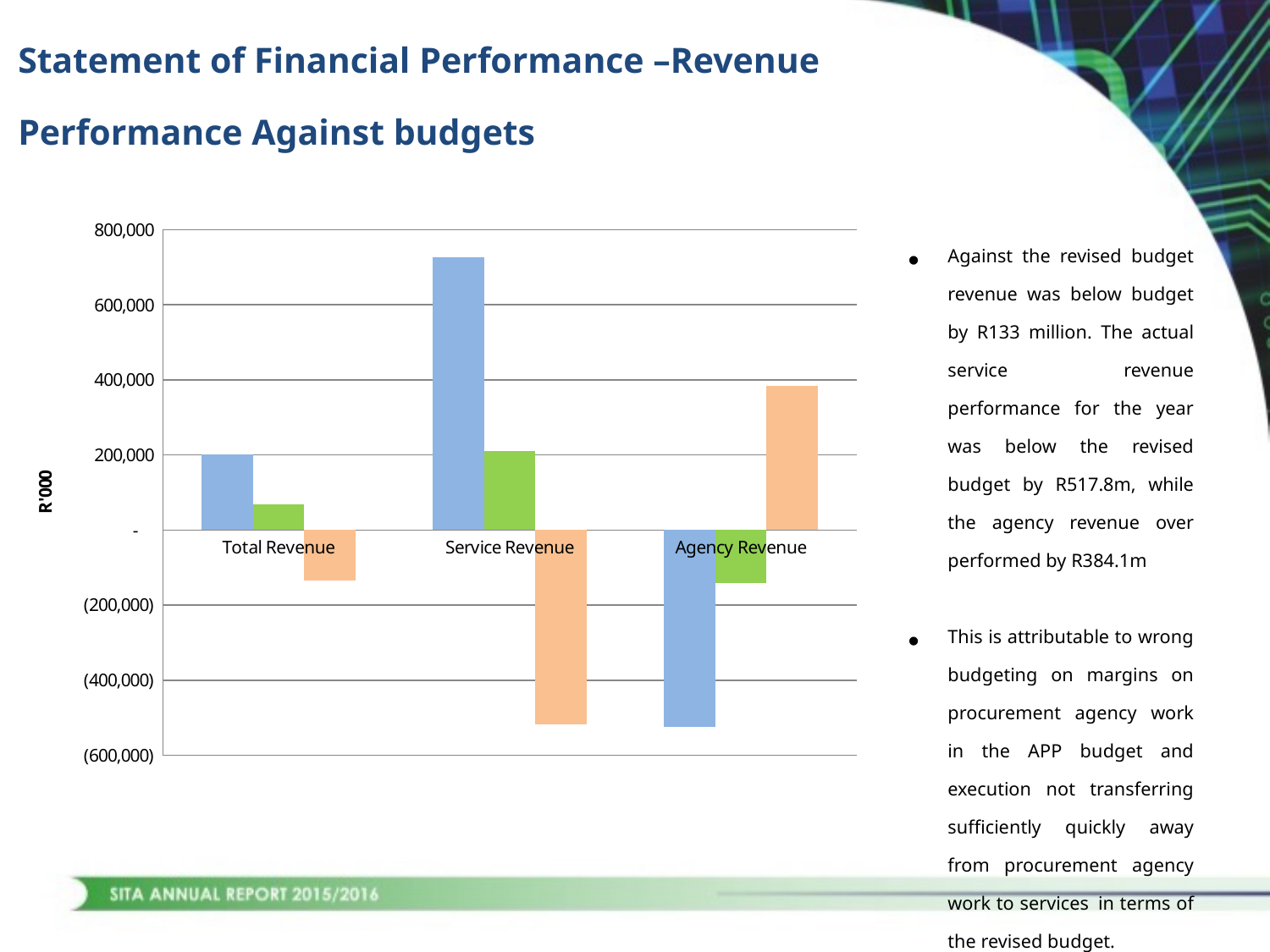
Which is larger: the blue bar for Total Revenue or the green bar for Total Revenue? the blue bar Is the value of the orange bar for Agency Revenue greater or less than 400,000? less Is the value of the green bar for Total Revenue greater or less than 200,000? less What is the label on the vertical axis of the chart? R'000 Is the value of the blue bar for Agency Revenue greater or less than (400,000)? less Which category contains the tallest positive bar in the chart? Service Revenue How many bars are plotted for each category in the chart? 3 How many categories are shown on the x axis of the chart? 3 What type of chart is shown on the slide? bar chart